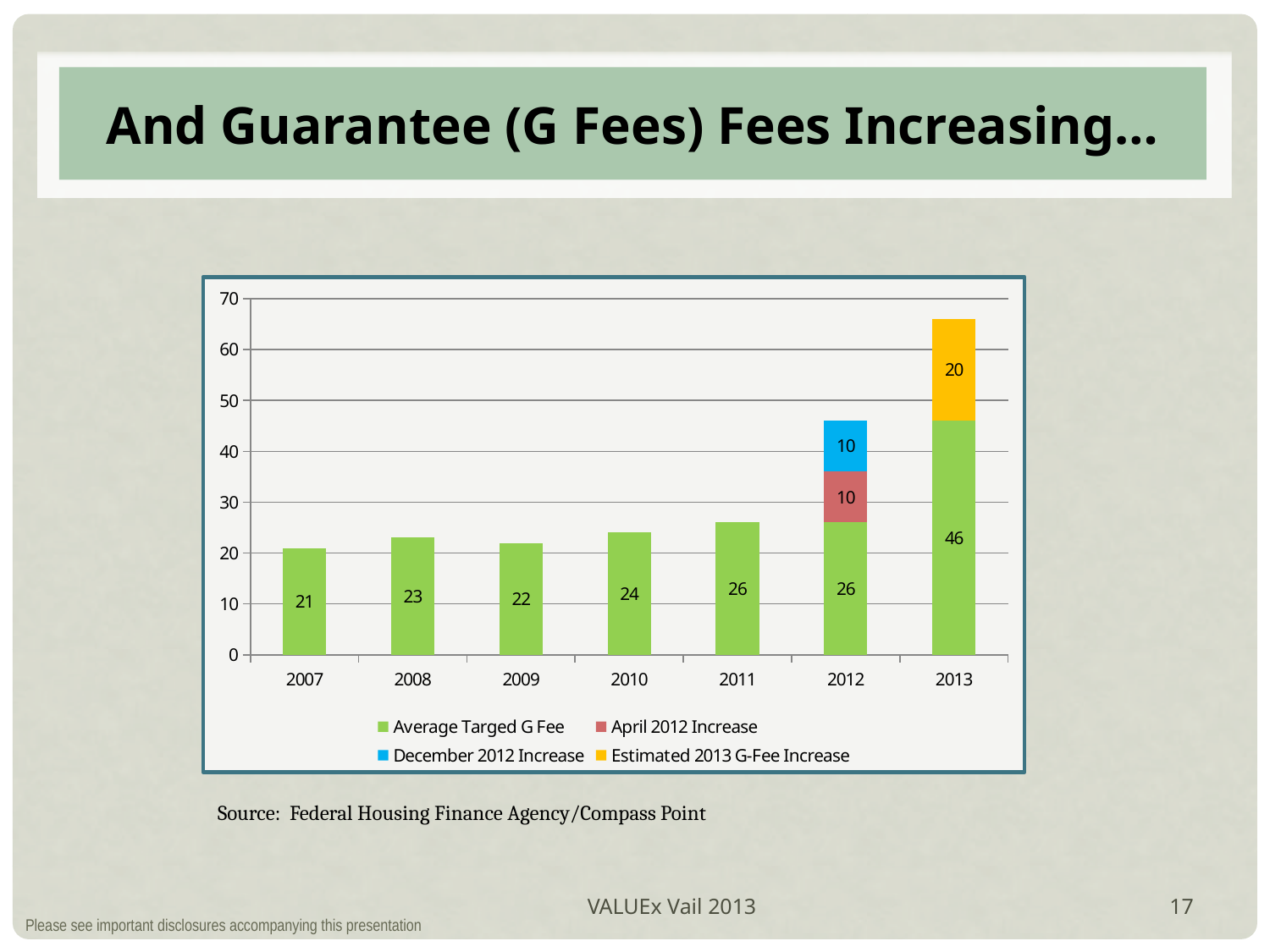
What is the Average Targed G Fee value for 2013? 46 What is the difference between the Average Targed G Fee in 2013 and in 2012? 20 Which year has the lowest Average Targed G Fee? 2007 How many years are shown on the x axis? 7 Which year has the highest Average Targed G Fee? 2013 What is the total of the stacked bar for 2012? 46 What is the value of the April 2012 Increase segment in 2012? 10 Is the Average Targed G Fee in 2008 larger or smaller than in 2009? larger How many series does the legend list? 4 What is the value of the Estimated 2013 G-Fee Increase segment in 2013? 20 What is the Average Targed G Fee value for 2007? 21 What is the total of the stacked bar for 2013? 66